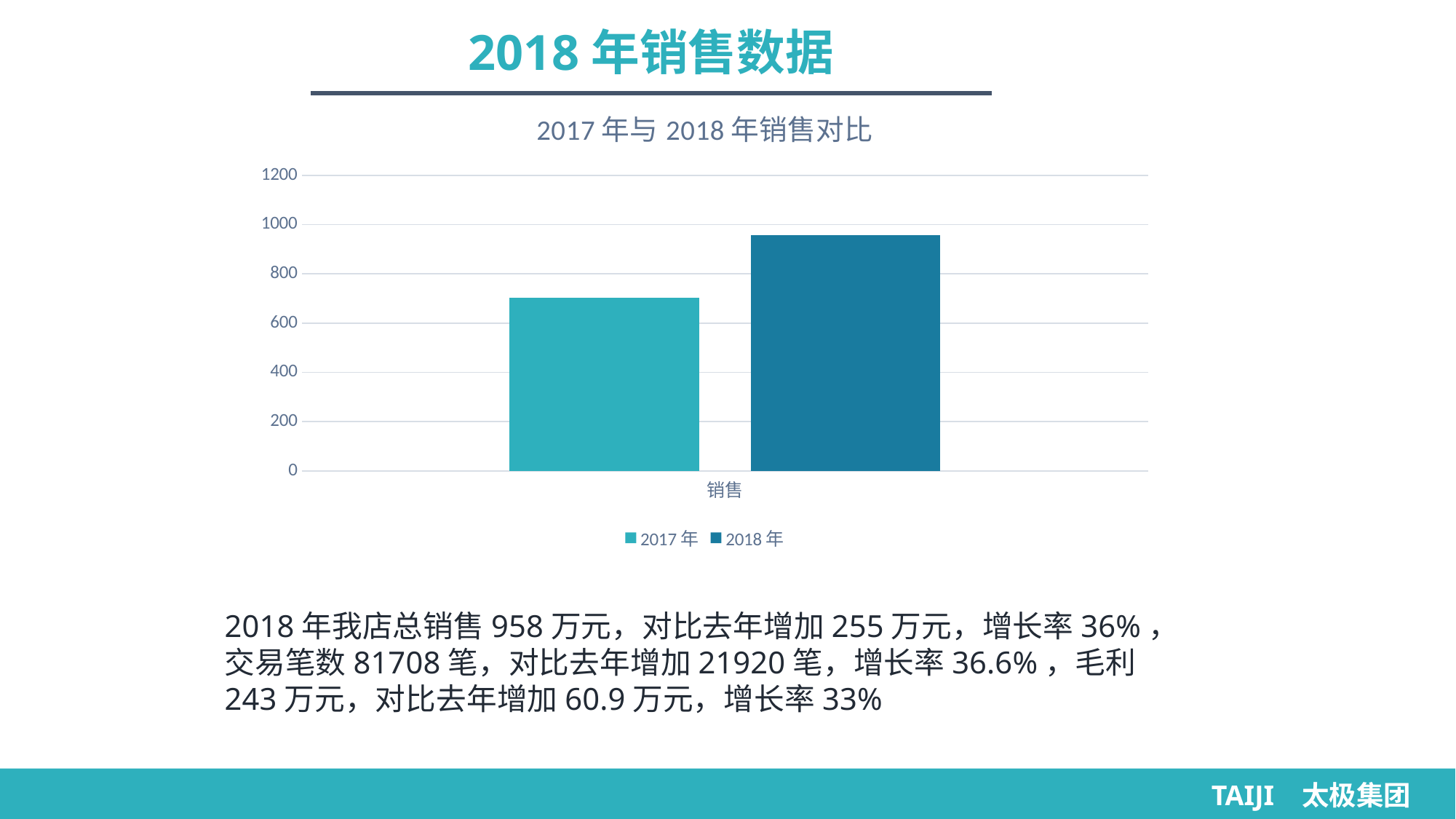
Is the 2018 年 bar larger or smaller than the 2017 年 bar? larger Which series has the lower bar in the chart? 2017 年 How many categories are shown on the x axis of the chart? 1 What kind of chart is shown on the slide? bar chart What is the title of the chart? 2017 年与 2018 年销售对比 Which series has the higher bar in the chart? 2018 年 What is the label of the category on the x axis? 销售 Is the value for 2017 年 greater or less than 600? greater Is the value for 2017 年 greater or less than 800? less According to the slide, what was the total sales for 2018 年 (in 万元)? 958 万元 Is the value for 2018 年 greater or less than 800? greater How many series does the chart legend list? 2